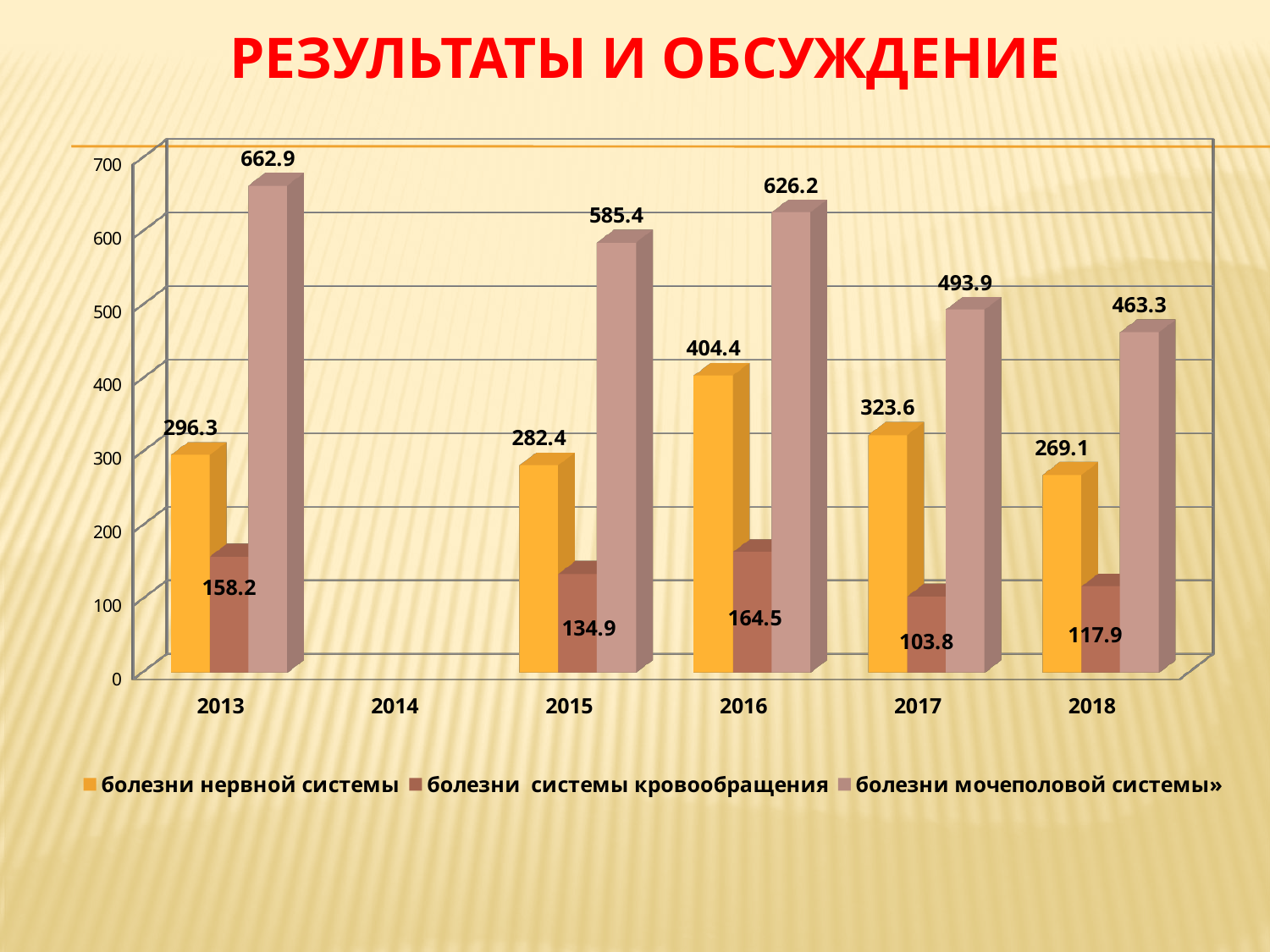
What is the difference between the values for болезни мочеполовой системы in 2013 and 2018? 199.6 How many series does the legend list? 3 What is the value for болезни мочеполовой системы in 2018? 463.3 Which year on the x axis has no bars plotted? 2014 What is the value for болезни мочеполовой системы in 2013? 662.9 In which year is the value for болезни мочеполовой системы highest? 2013 What kind of chart is shown on the slide? bar chart What is the value for болезни нервной системы in 2016? 404.4 Does the value for болезни мочеполовой системы rise or fall from 2016 to 2018? fall In which year is the value for болезни системы кровообращения lowest? 2017 Which is larger: the value for болезни нервной системы in 2015 or in 2017? 2017 What is the value for болезни системы кровообращения in 2017? 103.8